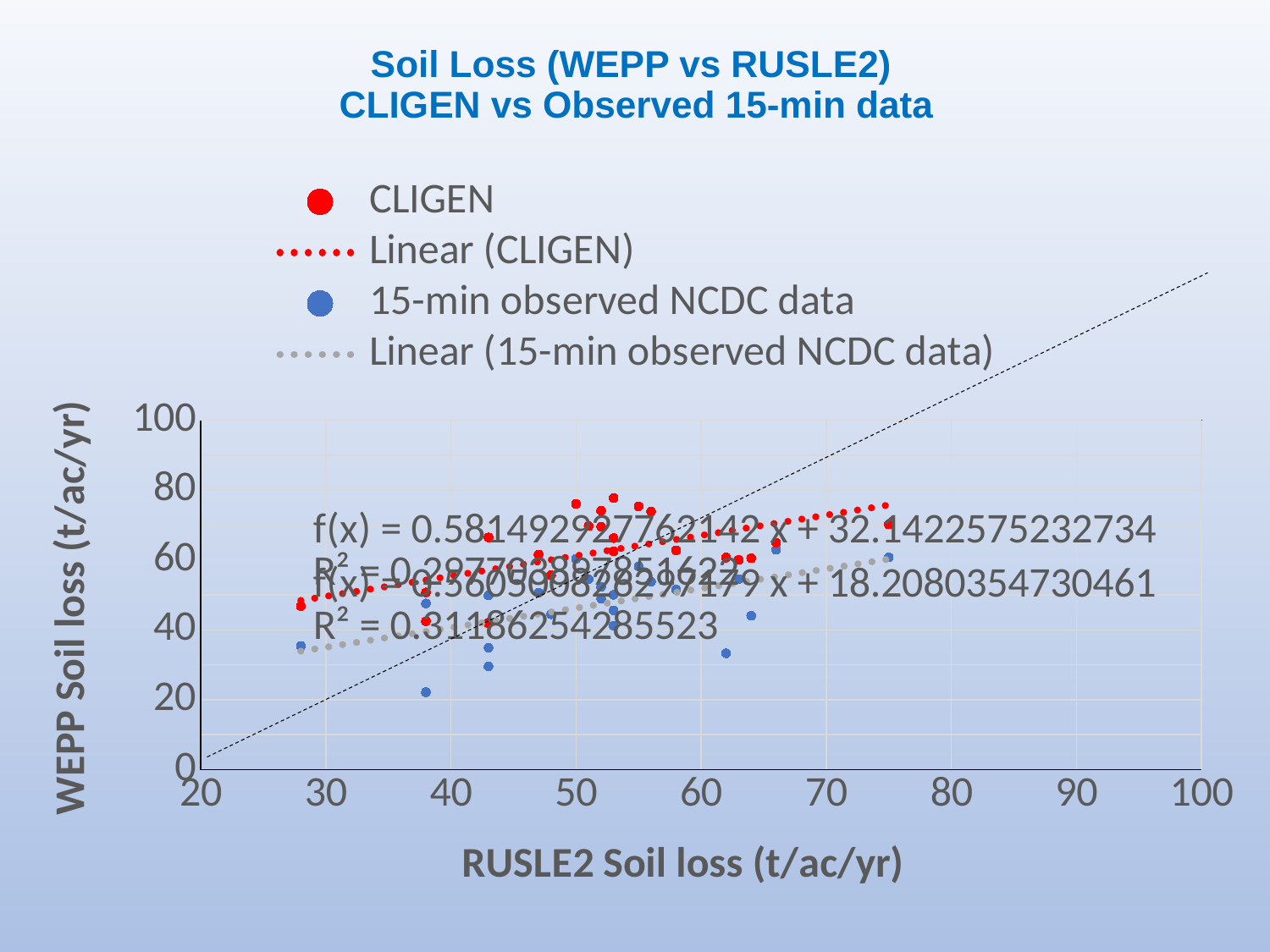
What is the intercept shown in the trendline equation for the 15-min observed NCDC data? 18.2080354730461 What kind of chart is shown on the slide? Scatter chart Is the WEPP soil loss value for the CLIGEN data point at RUSLE2 soil loss 75 greater or less than 60? greater Which trendline lies higher on the chart, Linear (CLIGEN) or Linear (15-min observed NCDC data)? Linear (CLIGEN) Does the CLIGEN linear trendline rise or fall as RUSLE2 soil loss increases? Rise What is the title of the chart? Soil Loss (WEPP vs RUSLE2) CLIGEN vs Observed 15-min data What R² value is shown for the 15-min observed NCDC data trendline? 0.31186254285523 What is the label of the horizontal axis? RUSLE2 Soil loss (t/ac/yr) How many entries does the chart legend list? 4 What is the intercept shown in the trendline equation for CLIGEN (f(x) = 0.5814929277621142 x + ...)? 32.1422575232734 Does the linear trendline for the 15-min observed NCDC data rise or fall along the x axis? Rise